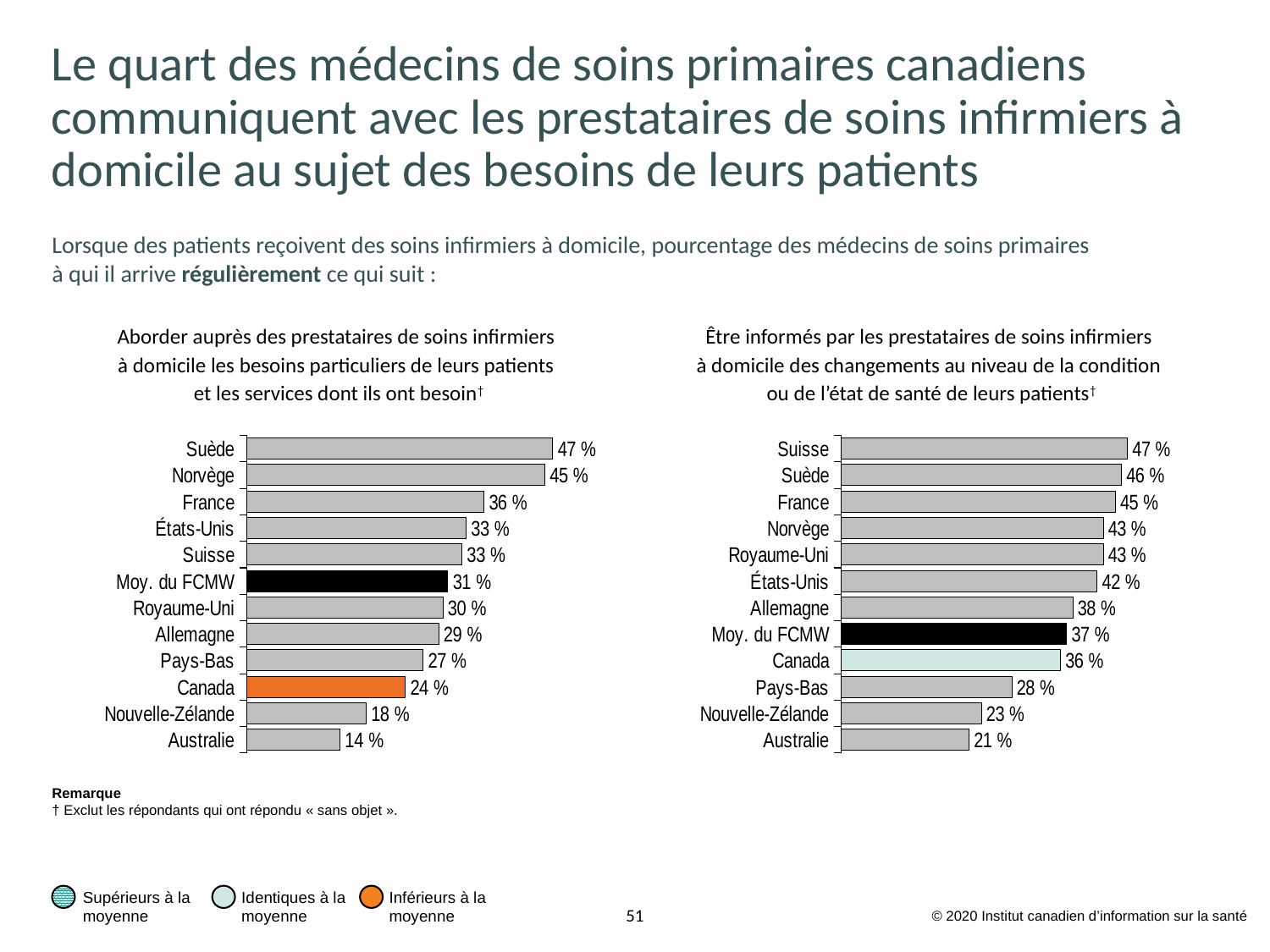
In the left chart, what is the value for Canada? 24 % In the right chart, which is larger, the value for Allemagne or the value for Canada? Allemagne In the right chart, what is the value for Nouvelle-Zélande? 23 % In the right chart, which country has the lowest value? Australie How many countries or categories are shown in the left chart? 12 In the right chart, what is the value for Moy. du FCMW? 37 % In the left chart, which is larger, the value for Norvège or the value for France? Norvège In the left chart, which country has the highest value? Suède In the right chart, what is the difference between the values for Canada and Pays-Bas? 8 % In the left chart, what is the difference between the values for Suède and Australie? 33 % What kind of chart is the right chart? Bar chart In the left chart, what colour is the bar for Canada? Orange